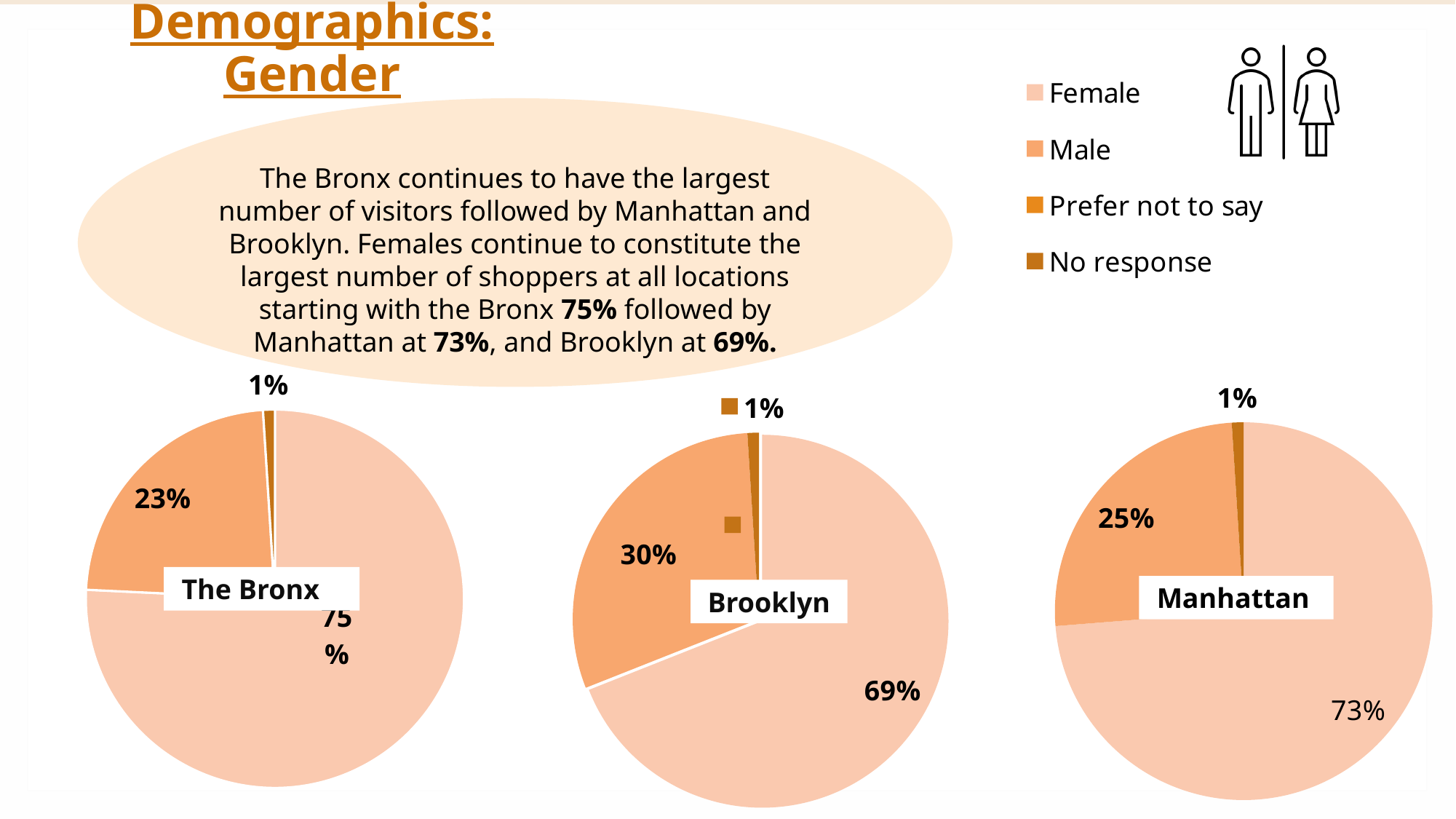
In the Brooklyn pie chart, what share of visitors is Male? 30% In The Bronx pie chart, what is the difference between the Female and Male shares? 52 percentage points In The Bronx pie chart, what share of visitors is Female? 75% How many pie charts are on the slide? 3 In the Brooklyn pie chart, which category has the largest slice? Female How many categories does the legend list? 4 In The Bronx pie chart, what share of visitors is Male? 23% In the Brooklyn pie chart, what share of visitors is Female? 69% In the Manhattan pie chart, what share of visitors is Female? 73% What kind of charts are shown on the slide? Pie charts In the Manhattan pie chart, what share of visitors is Male? 25% Which has a larger Male share, the Brooklyn pie chart or the Manhattan pie chart? Brooklyn